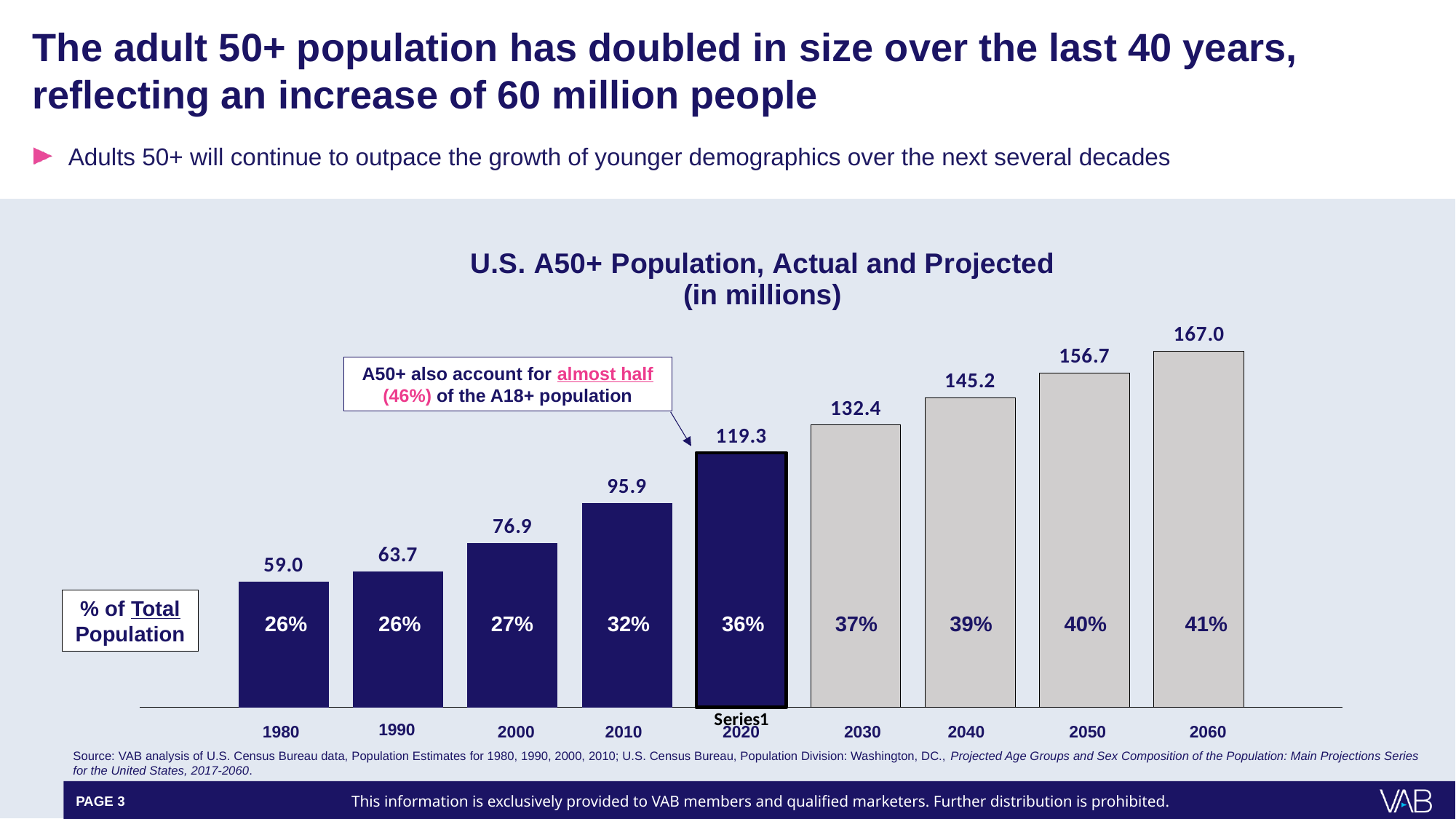
How many years (bars) are shown in the chart? 9 What is the difference between the 2060 value and the 2020 value? 47.7 What is the value shown for 1980? 59.0 Which is larger, the value for 2030 or the value for 2010? 2030 What is the U.S. A50+ population value shown for 2020? 119.3 Which year has the highest A50+ population value? 2060 What percentage of the total population does the A50+ group represent in 2060? 41% Do the values rise or fall from 1980 to 2060? Rise What is the difference between the 2010 value and the 2000 value? 19.0 What kind of chart is shown on the slide? Bar chart Which year has the lowest A50+ population value? 1980 What is the title of the chart? U.S. A50+ Population, Actual and Projected (in millions)